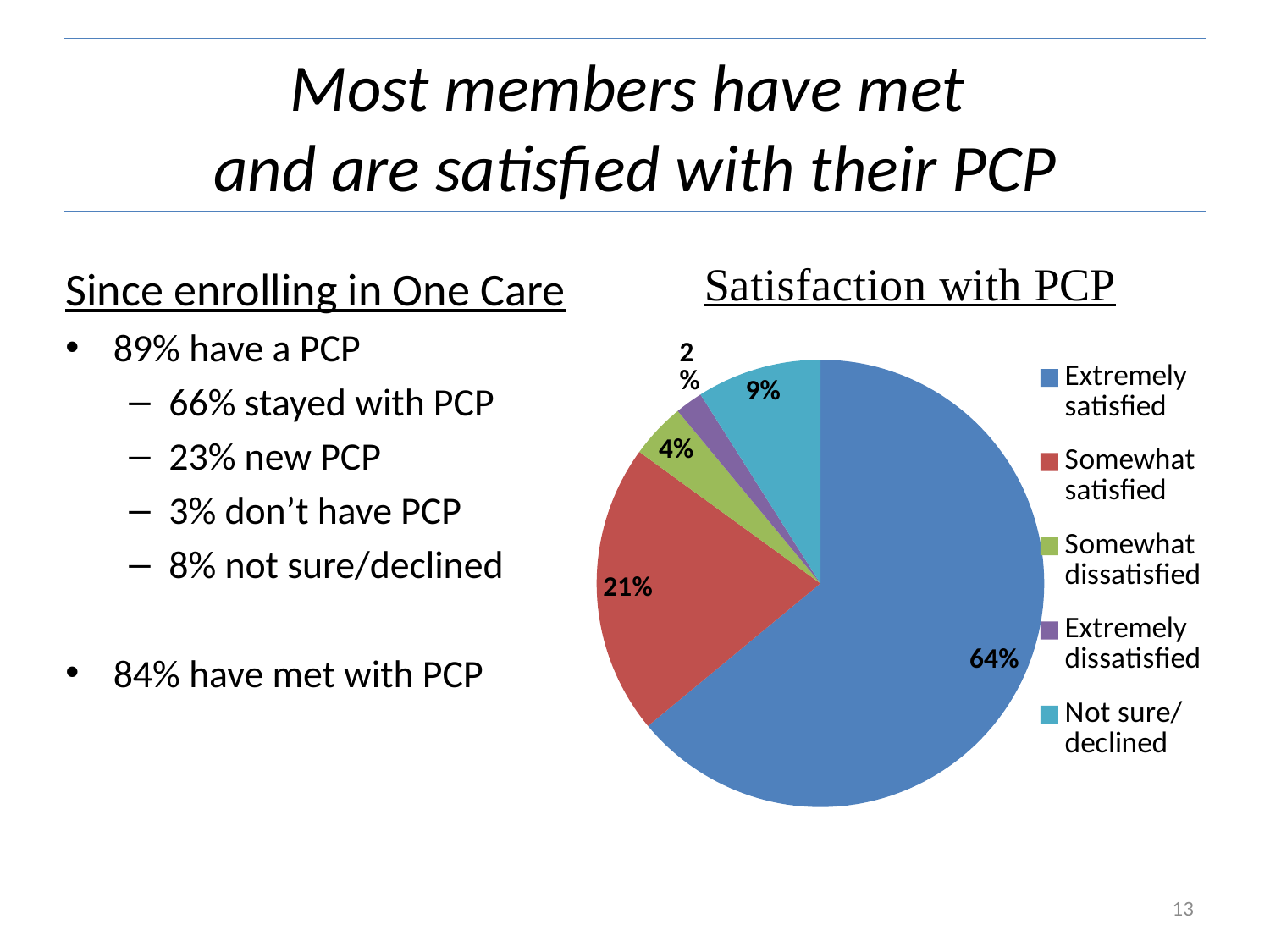
What share of the pie is labelled Somewhat dissatisfied? 4% What share of the pie is labelled Somewhat satisfied? 21% What is the difference between the Extremely satisfied and Somewhat satisfied shares? 43% What share of the pie is labelled Not sure/declined? 9% What is the title of the chart? Satisfaction with PCP Which is larger, the Not sure/declined slice or the Somewhat dissatisfied slice? Not sure/declined What kind of chart is shown on the slide? pie chart How many categories does the legend list? 5 Which category has the smallest slice of the pie? Extremely dissatisfied Which category has the largest slice of the pie? Extremely satisfied